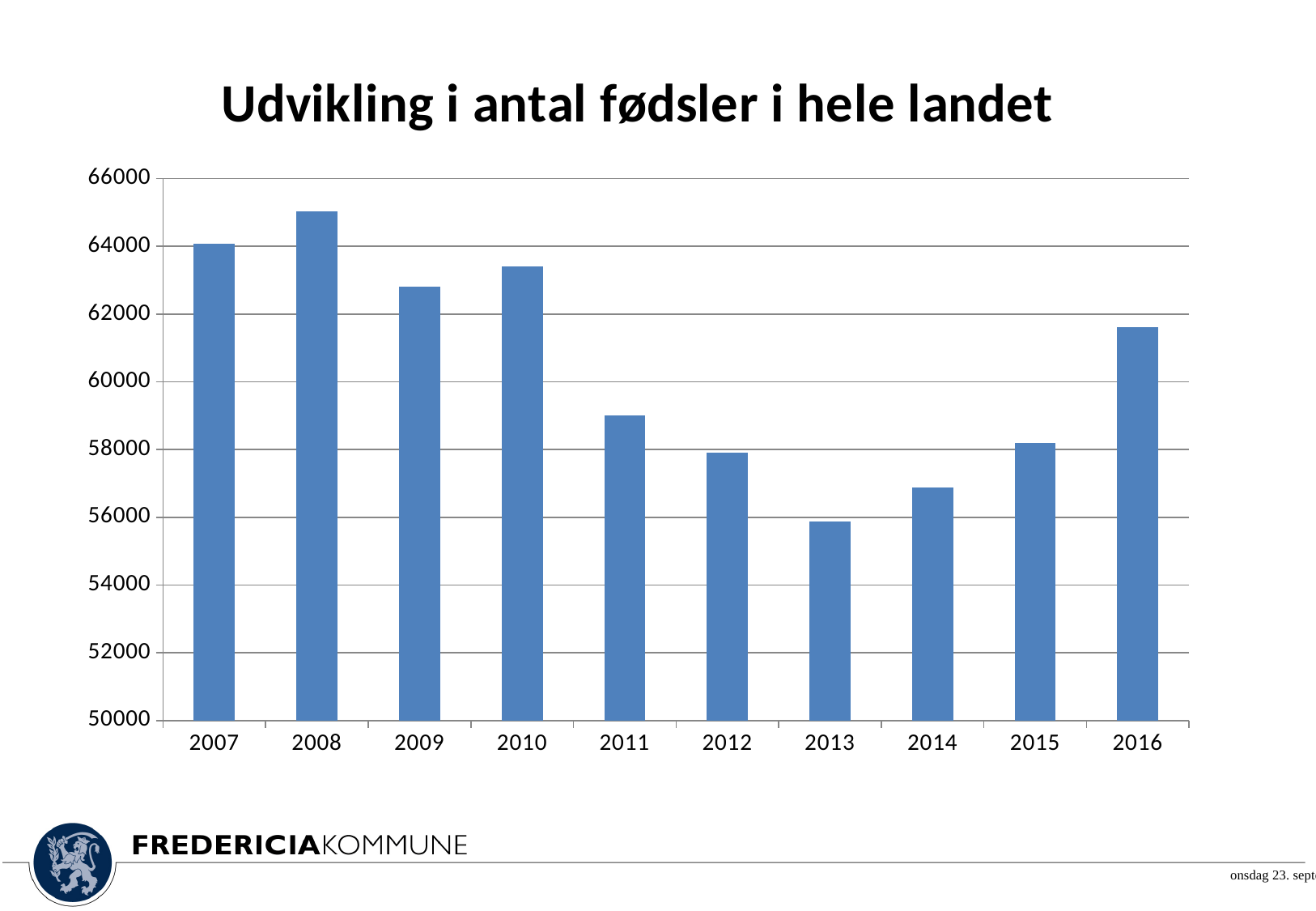
Is the value for 2011 greater or less than 58000? greater Is the value for 2016 greater or less than 62000? less Which year has the highest number of births in the chart? 2008 How many years are shown on the x axis of the chart? 10 Which year has the larger value, 2015 or 2016? 2016 What kind of chart is shown on the slide? bar chart What is the title of the chart? Udvikling i antal fødsler i hele landet Is the value for 2008 greater or less than 64000? greater Which year has the larger value, 2009 or 2010? 2010 Do the values rise or fall from 2013 to 2016? rise Which year has the lowest number of births in the chart? 2013